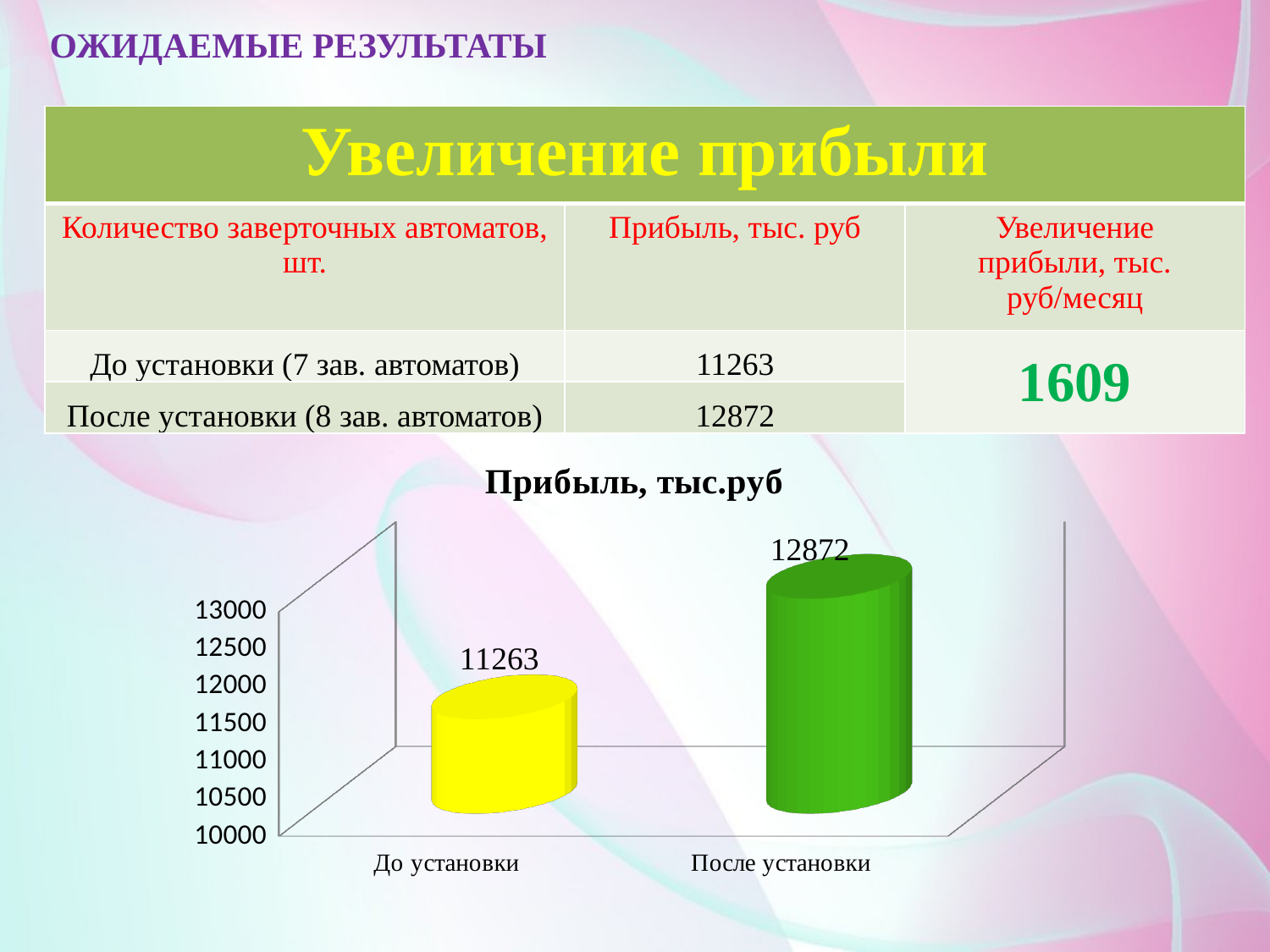
Do the values rise or fall from "До установки" to "После установки"? rise What kind of chart is shown on the slide? bar chart What is the value for "До установки" in the chart? 11263 What is the title of the chart? Прибыль, тыс.руб Which is larger: the value for "До установки" or "После установки"? После установки How many categories are shown in the chart? 2 Is the value for "После установки" greater or less than 12500? greater Is the value for "До установки" greater or less than 11500? less What is the difference between the values for "После установки" and "До установки"? 1609 What is the value for "После установки" in the chart? 12872 Which category has the highest value in the chart? После установки Which category has the lowest value in the chart? До установки